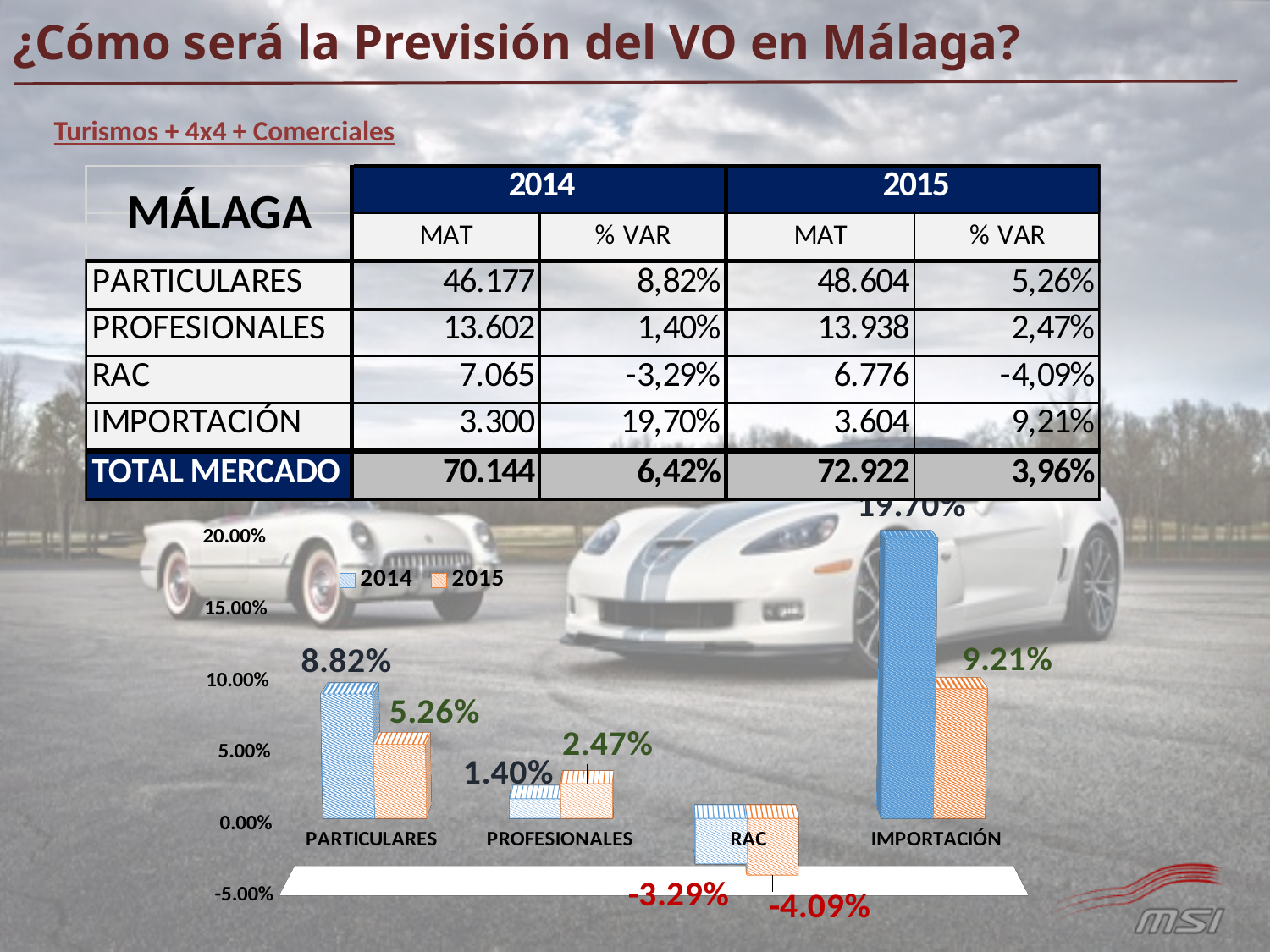
Which category has the highest 2014 value in the chart? IMPORTACIÓN What is the 2014 value for PARTICULARES in the chart? 8.82% How many series does the chart legend list? 2 What is the 2015 value for PROFESIONALES in the chart? 2.47% What is the 2015 value for RAC in the chart? -4.09% Which category has the lowest 2015 value in the chart? RAC What kind of chart is shown on the slide? bar chart What is the difference between the 2014 and 2015 values for PARTICULARES in the chart? 3.56% Which series in the chart is shown in orange? 2015 What is the 2015 value for IMPORTACIÓN in the chart? 9.21% How many categories are shown on the x axis of the chart? 4 In the chart, which is larger for PROFESIONALES: the 2014 value or the 2015 value? 2015